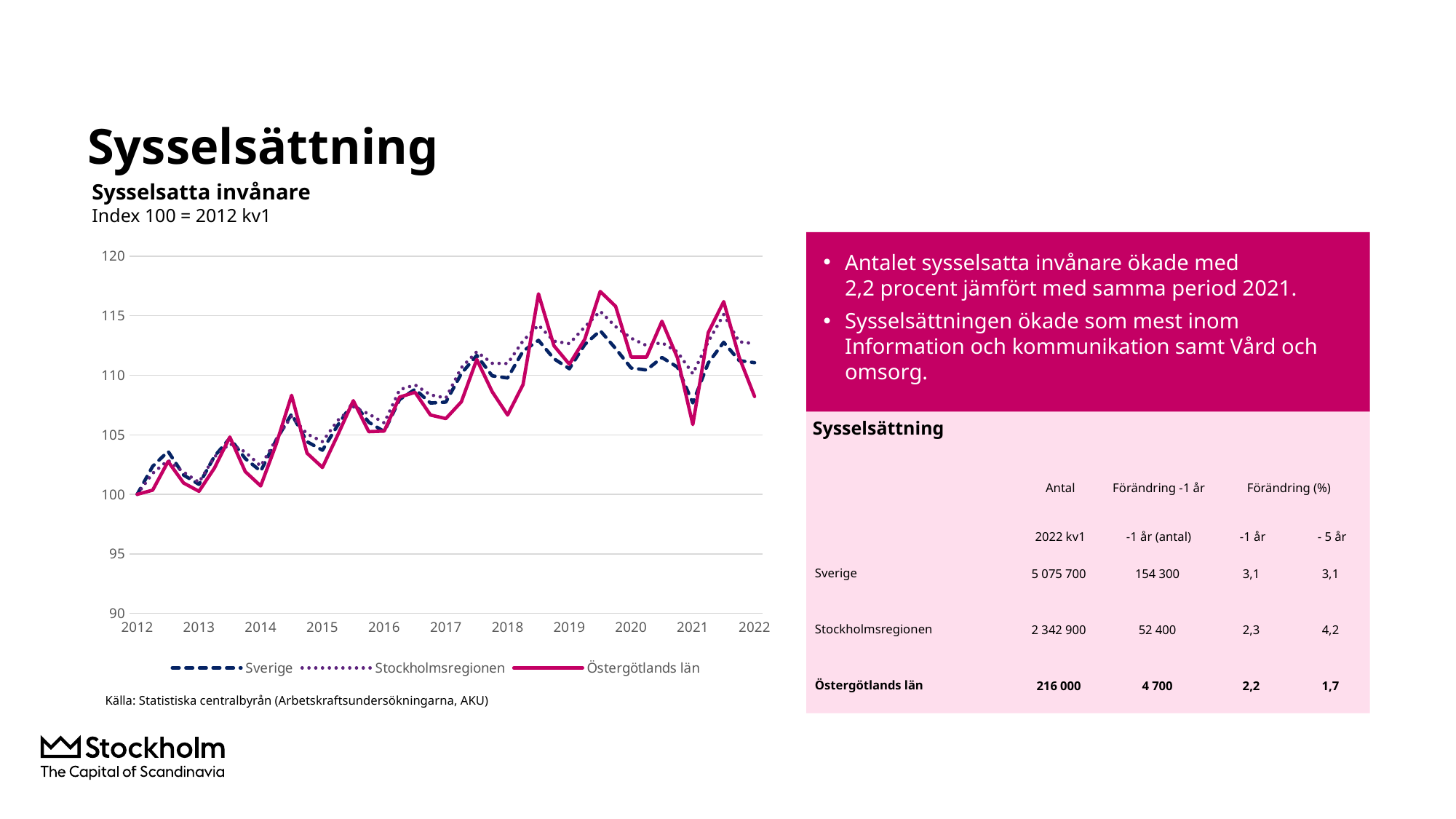
Is the value for Stockholmsregionen at the end of the chart in 2022 greater or less than 110? greater Is the peak value for Östergötlands län around 2019 greater or less than 115? greater Overall, do the index values rise or fall from 2012 to 2022 in the chart? rise Is the value for Östergötlands län at the 2021 dip greater or less than 110? less At the end of the chart in 2022, which series has the higher value: Stockholmsregionen or Östergötlands län? Stockholmsregionen What kind of chart is shown on the slide? line chart What is the title of the chart? Sysselsatta invånare What is the index value for all three series at the start of the chart in 2012? 100 How many series does the chart legend list? 3 What is the highest value shown on the y axis of the chart? 120 How many year labels are shown on the x axis of the chart? 11 Which series in the chart is drawn as a solid line? Östergötlands län